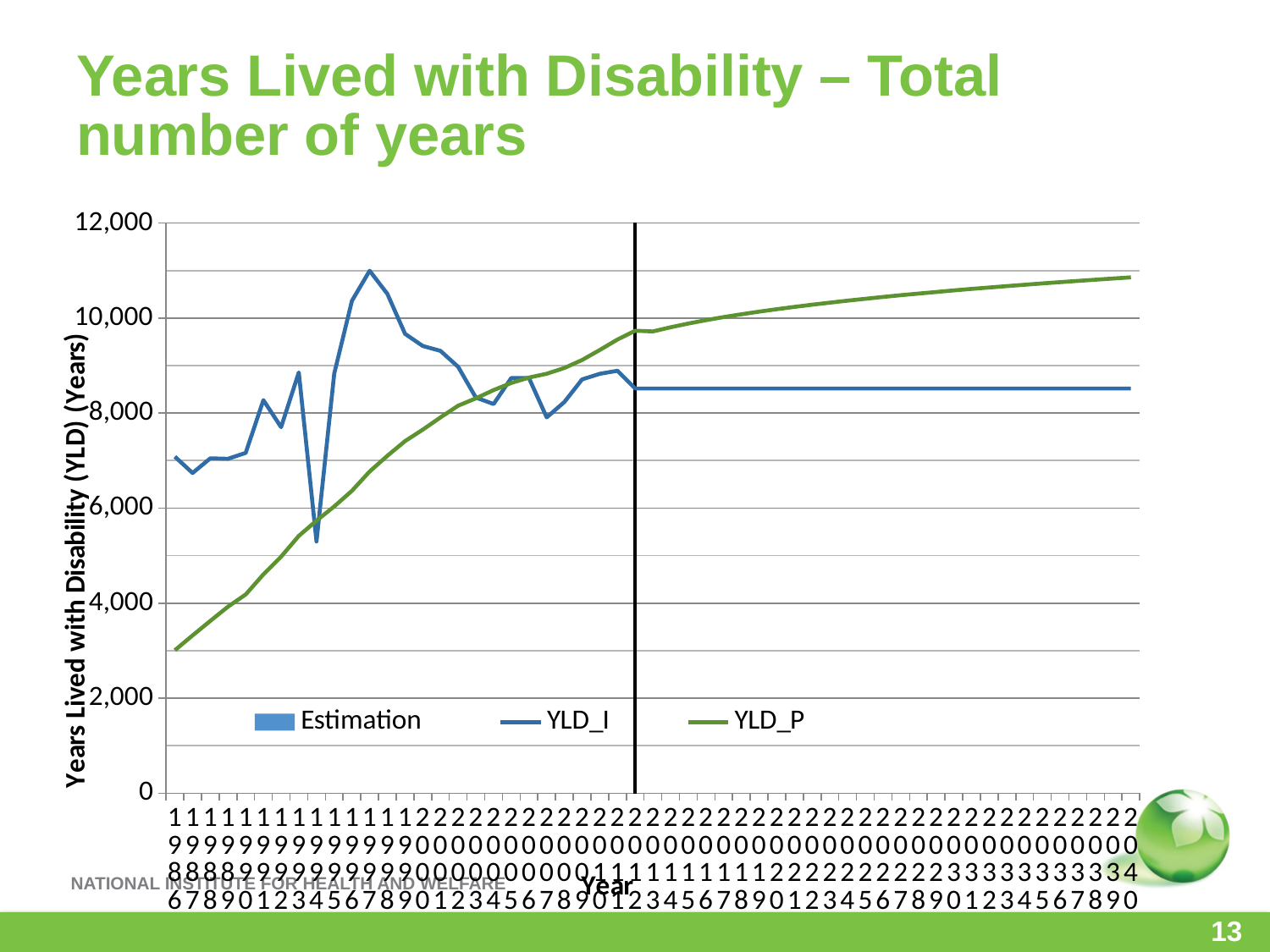
Is the value of YLD_I in 2040 greater or less than 10,000? less Is the value of YLD_P in 1986 greater or less than 4,000? less Is the value of YLD_P in 2040 greater or less than 10,000? greater How many entries does the chart legend list? 3 What is the title of the chart's vertical axis? Years Lived with Disability (YLD) (Years) Which series has the larger value in 2040, YLD_I or YLD_P? YLD_P In which year does the YLD_P series reach its lowest value? 1986 What are the names of the two plotted line series in the legend? YLD_I and YLD_P Which series has the larger value in 1986, YLD_I or YLD_P? YLD_I Does the YLD_P series rise or fall along the x axis from 1986 to 2040? Rise What kind of chart is shown on the slide? Combination bar and line chart